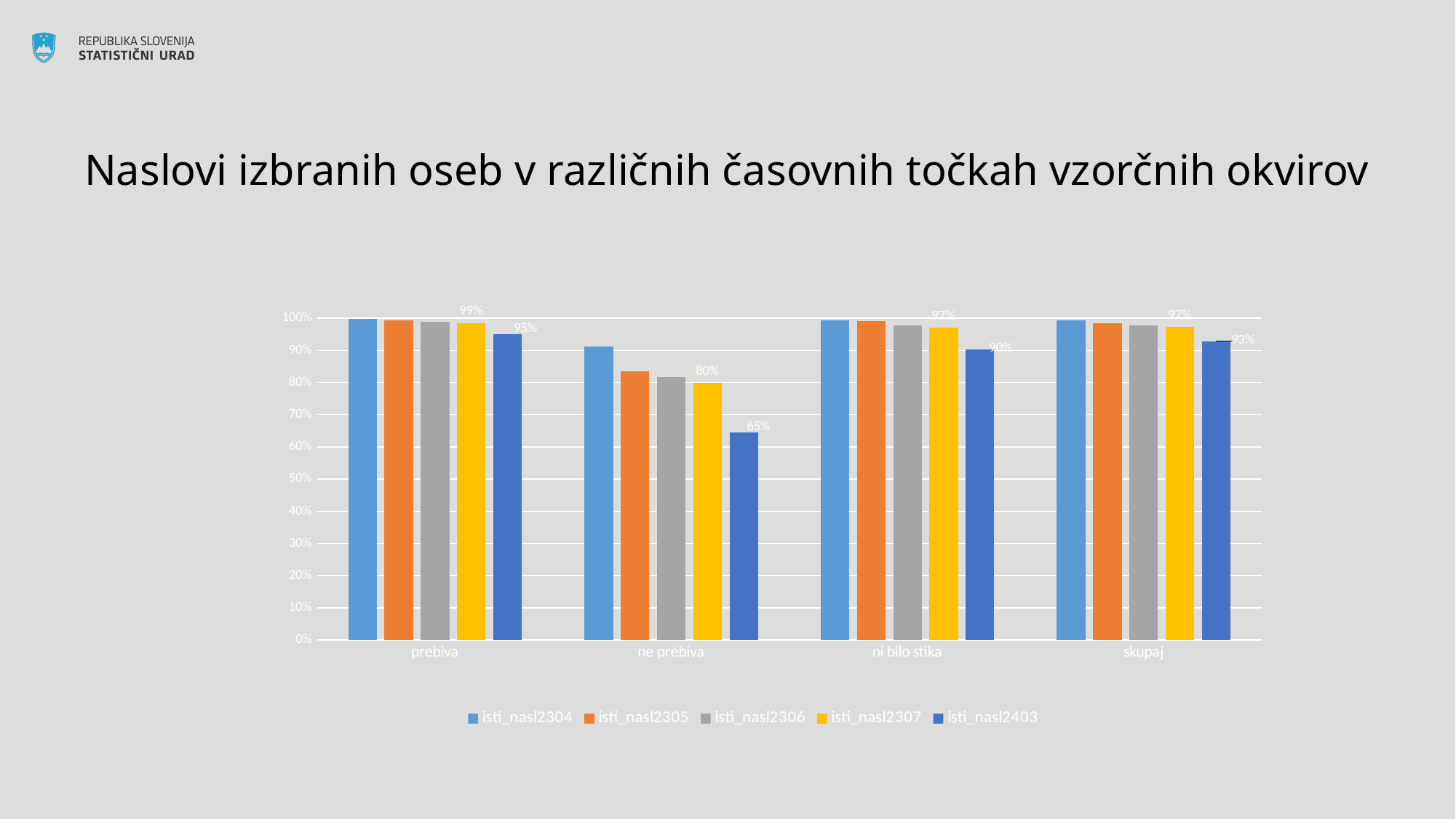
What is the value for isti_nasl2307 in the 'skupaj' category? 97% How many categories are shown on the x axis? 4 What is the difference between isti_nasl2307 and isti_nasl2403 in the 'ne prebiva' category? 15% What is the title of the slide? Naslovi izbranih oseb v različnih časovnih točkah vzorčnih okvirov What is the value for isti_nasl2307 in the 'ne prebiva' category? 80% What is the value for isti_nasl2403 in the 'prebiva' category? 95% Is the value for isti_nasl2304 in the 'ne prebiva' category greater or less than 80%? greater What kind of chart is shown on the slide? bar chart What is the value for isti_nasl2403 in the 'ne prebiva' category? 65% Which is larger: isti_nasl2403 in 'ni bilo stika' or isti_nasl2403 in 'ne prebiva'? ni bilo stika How many series does the legend list? 5 In which category is the isti_nasl2403 value lowest? ne prebiva